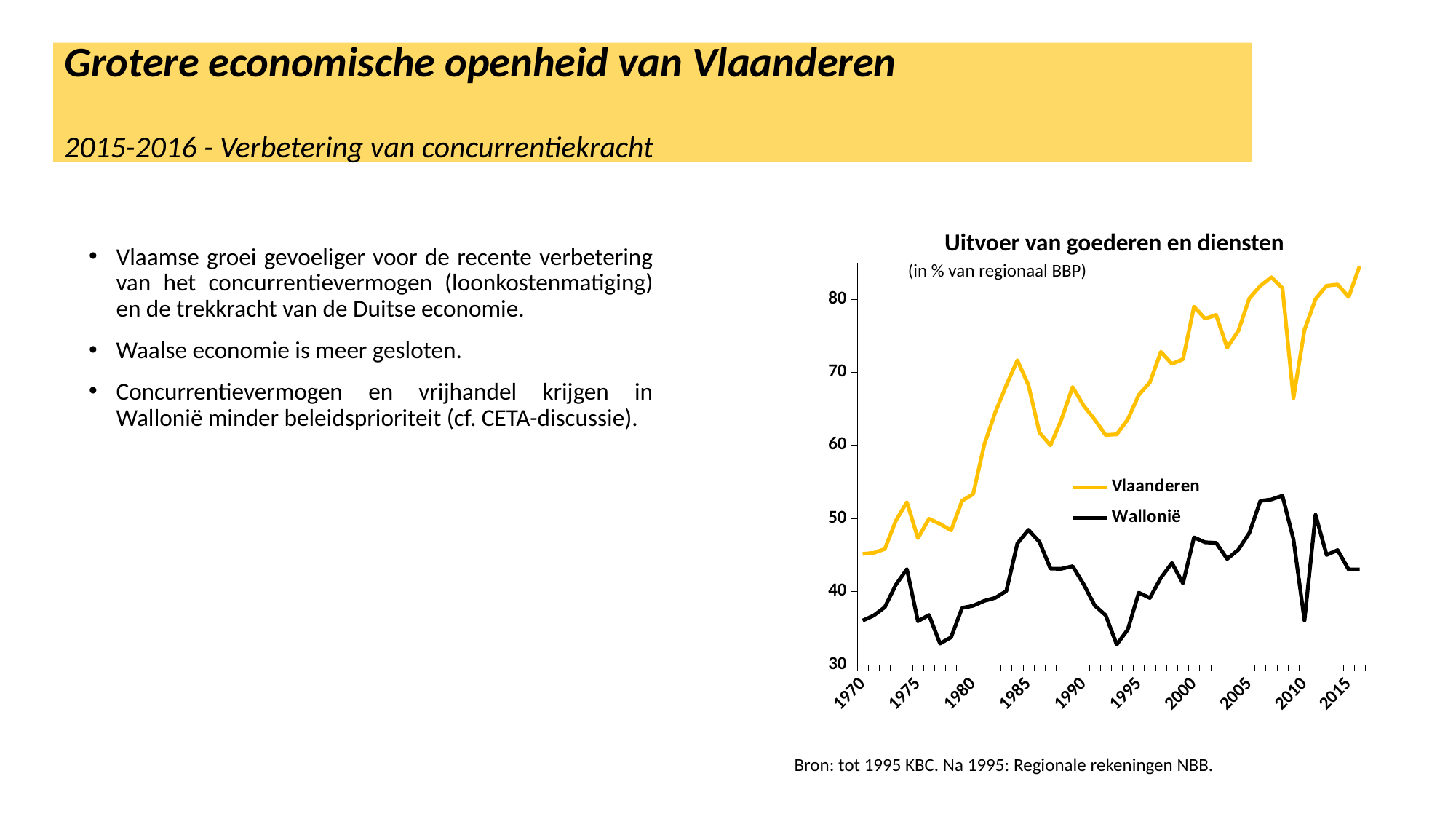
What is the title of the chart? Uitvoer van goederen en diensten Is the value for Vlaanderen in 1985 greater or less than 60? greater Is the value for Vlaanderen in 2005 greater or less than 70? greater Is the value for Wallonië in 2010 greater or less than 40? less In what unit are the values in the chart expressed, according to the subtitle? in % van regionaal BBP What kind of chart is shown on the slide? line chart Does the Vlaanderen line generally rise or fall from 1970 to 2015? rise How many series does the legend of the chart list? 2 Which series has the higher value in 2010, Vlaanderen or Wallonië? Vlaanderen